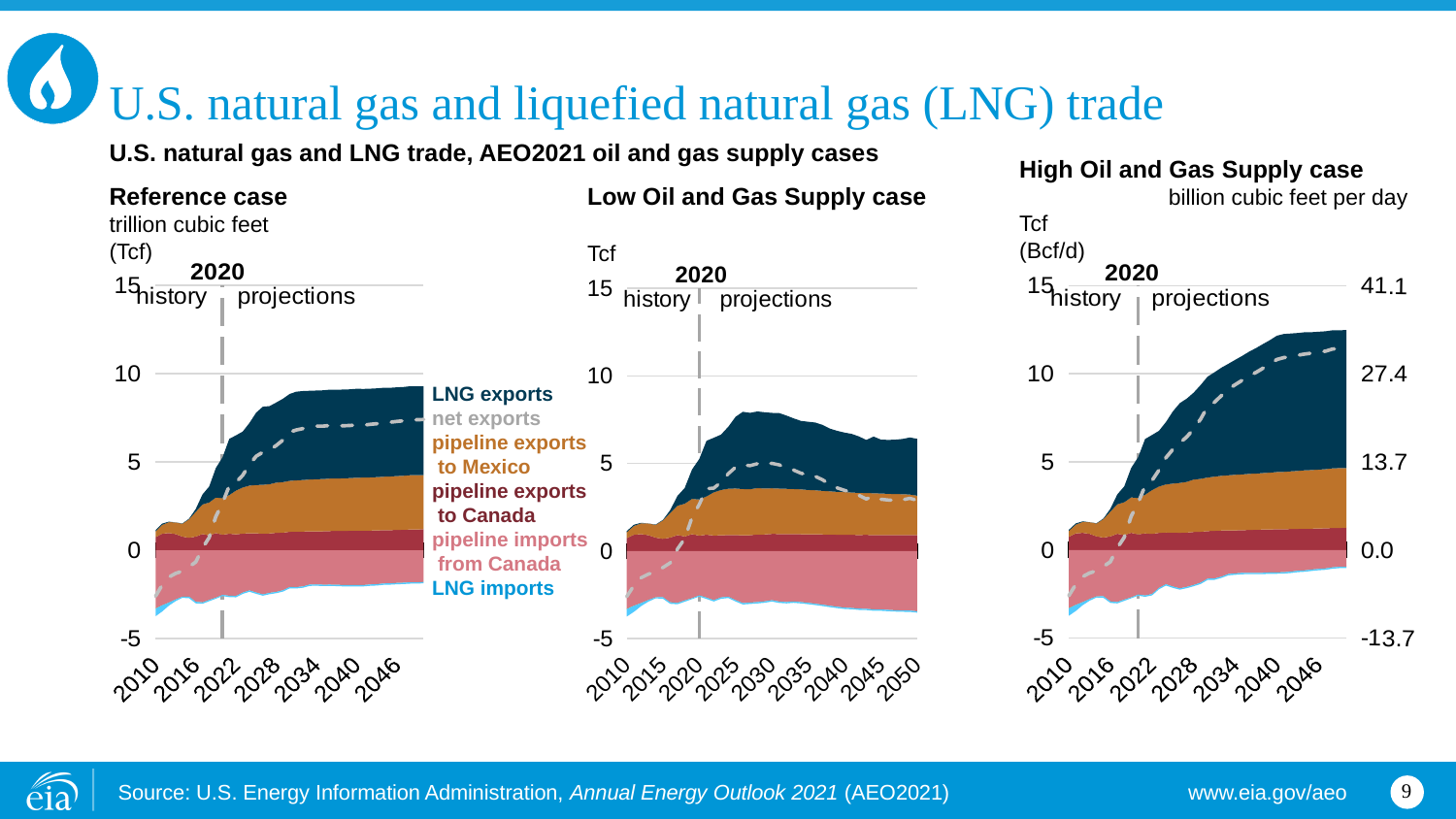
What kind of chart is the Reference case chart? stacked area chart In the High Oil and Gas Supply case chart, is the net exports value in 2046 greater or less than 10? greater In the Reference case chart, is the net exports value in 2010 greater or less than 0? less How many series does the legend between the Reference case and Low Oil and Gas Supply case charts list? 6 In the Reference case chart, is the net exports value in 2046 greater or less than 5? greater How many year labels are shown on the x axis of the Low Oil and Gas Supply case chart? 9 In the High Oil and Gas Supply case chart, what value on the right-hand axis (billion cubic feet per day) corresponds to 15 Tcf? 41.1 What year does the vertical dashed line separating history from projections mark in each chart? 2020 In the High Oil and Gas Supply case chart, does net exports rise or fall over the projection period? rise In the Low Oil and Gas Supply case chart, does net exports rise or fall between 2030 and 2045? fall